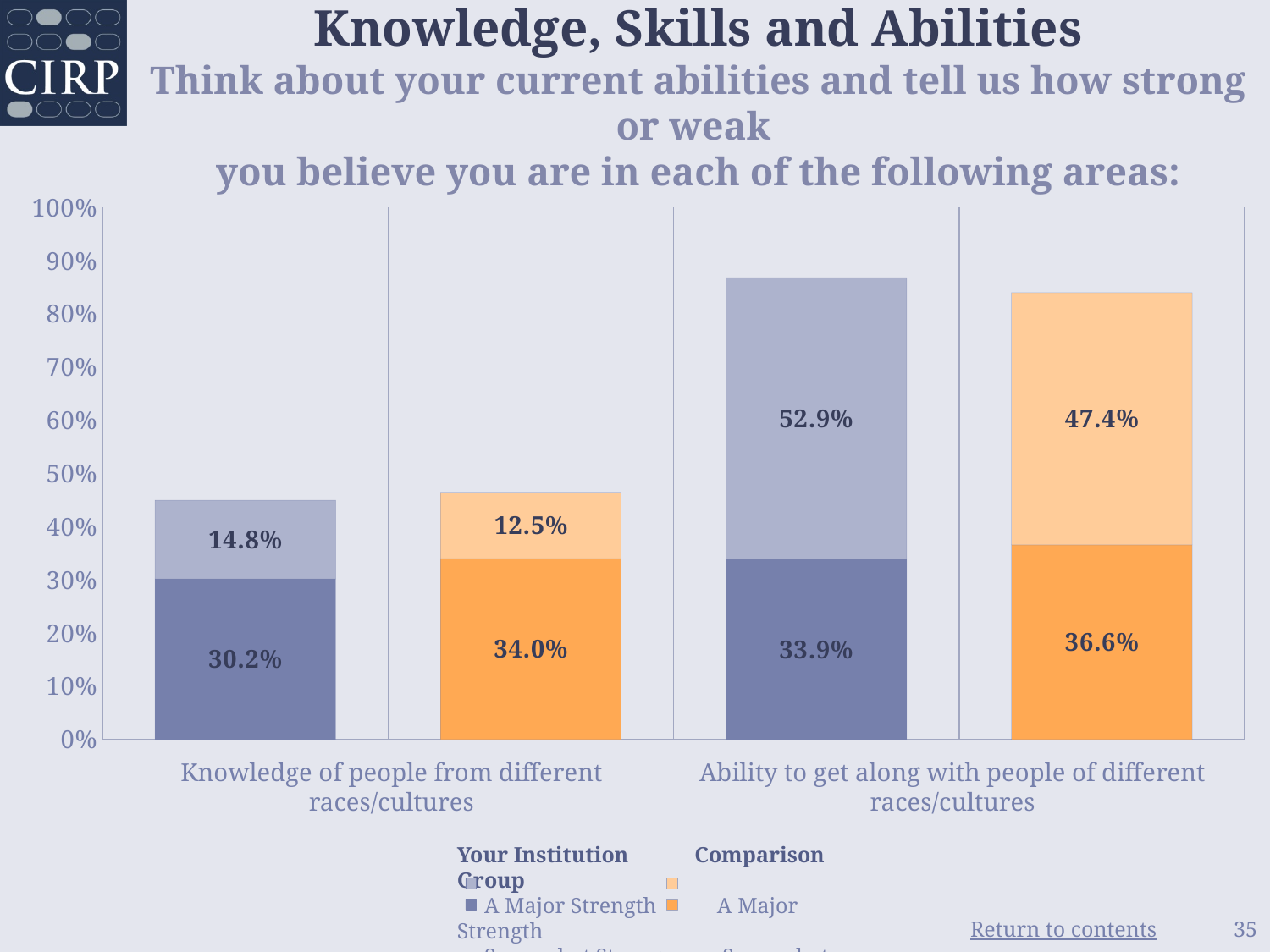
What kind of chart is shown on the slide? Stacked bar chart Is the total height of the Your Institution bar for 'Knowledge of people from different races/cultures' greater or less than 50%? less What is the total height of the Comparison Group stacked bar for 'Knowledge of people from different races/cultures'? 46.5% What value is shown in the upper (lighter) segment of the Your Institution bar for 'Ability to get along with people of different races/cultures'? 52.9% What is the total height of the Your Institution stacked bar for 'Ability to get along with people of different races/cultures'? 86.8% What is the difference between the Comparison Group and Your Institution 'A Major Strength' values for 'Knowledge of people from different races/cultures'? 3.8% For 'Ability to get along with people of different races/cultures', which group has the larger 'A Major Strength' value, Your Institution or the Comparison Group? Comparison Group What value is shown in the upper (lighter) segment of the Comparison Group bar for 'Knowledge of people from different races/cultures'? 12.5% How many categories are shown on the x axis? 2 What percentage of the Comparison Group rated 'Ability to get along with people of different races/cultures' as 'A Major Strength'? 36.6% What percentage of Your Institution students rated 'Knowledge of people from different races/cultures' as 'A Major Strength'? 30.2% Which of the four stacked bars reaches the greatest total height? Your Institution, Ability to get along with people of different races/cultures